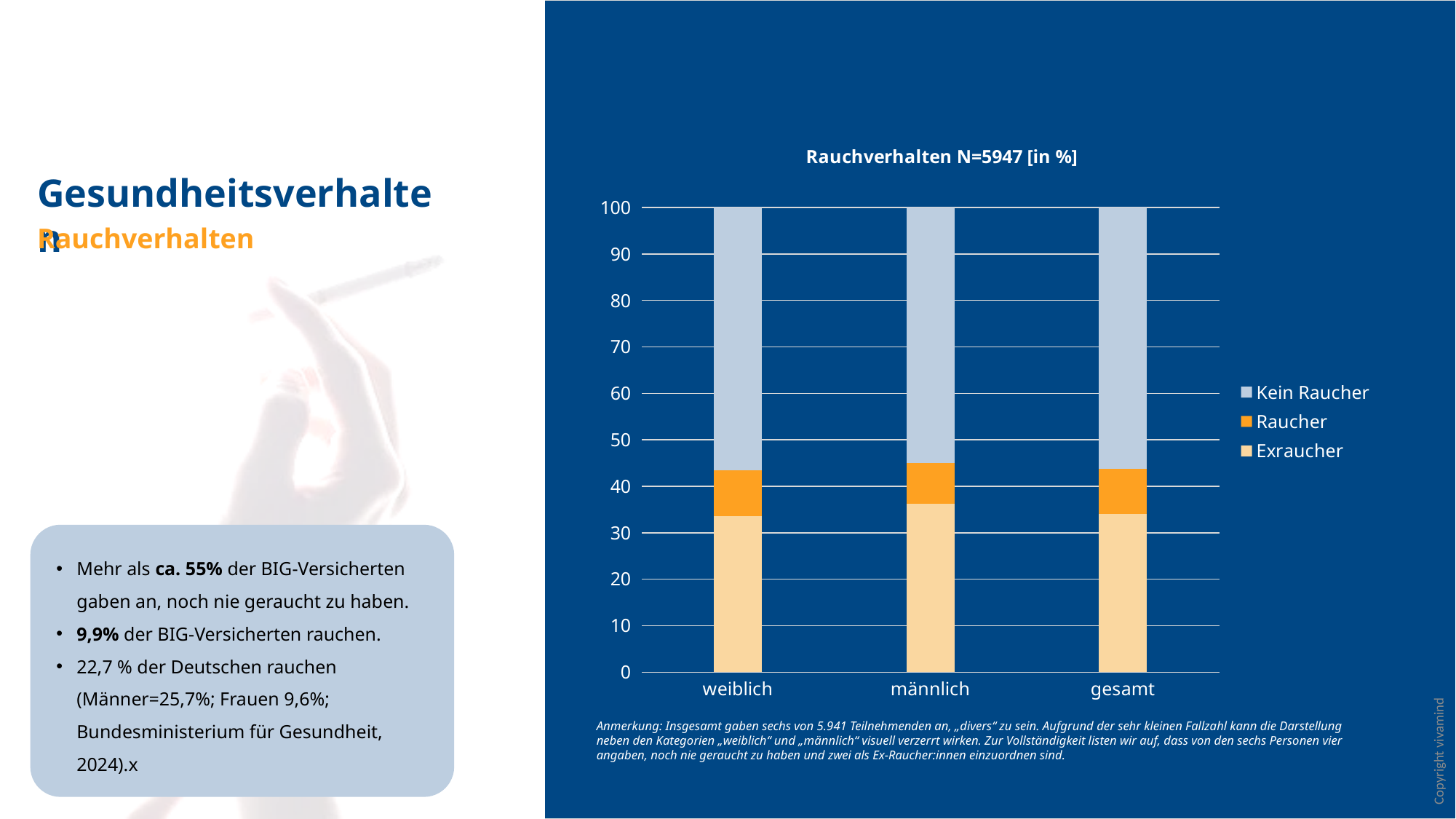
Which category has the largest Exraucher segment? männlich Which series are listed in the chart legend? Kein Raucher, Raucher, Exraucher Does the top of the Raucher segment for männlich lie above or below 50 on the axis? below Which category has the larger Exraucher segment, weiblich or männlich? männlich Is the Exraucher value for weiblich greater or less than 30? greater What is the total height of each stacked bar in the chart? 100 Is the Exraucher value for männlich greater or less than 40? less What kind of chart is shown on the slide? stacked bar chart How many series does the chart legend list? 3 How many categories are shown on the x axis of the chart? 3 What is the title of the chart? Rauchverhalten N=5947 [in %]